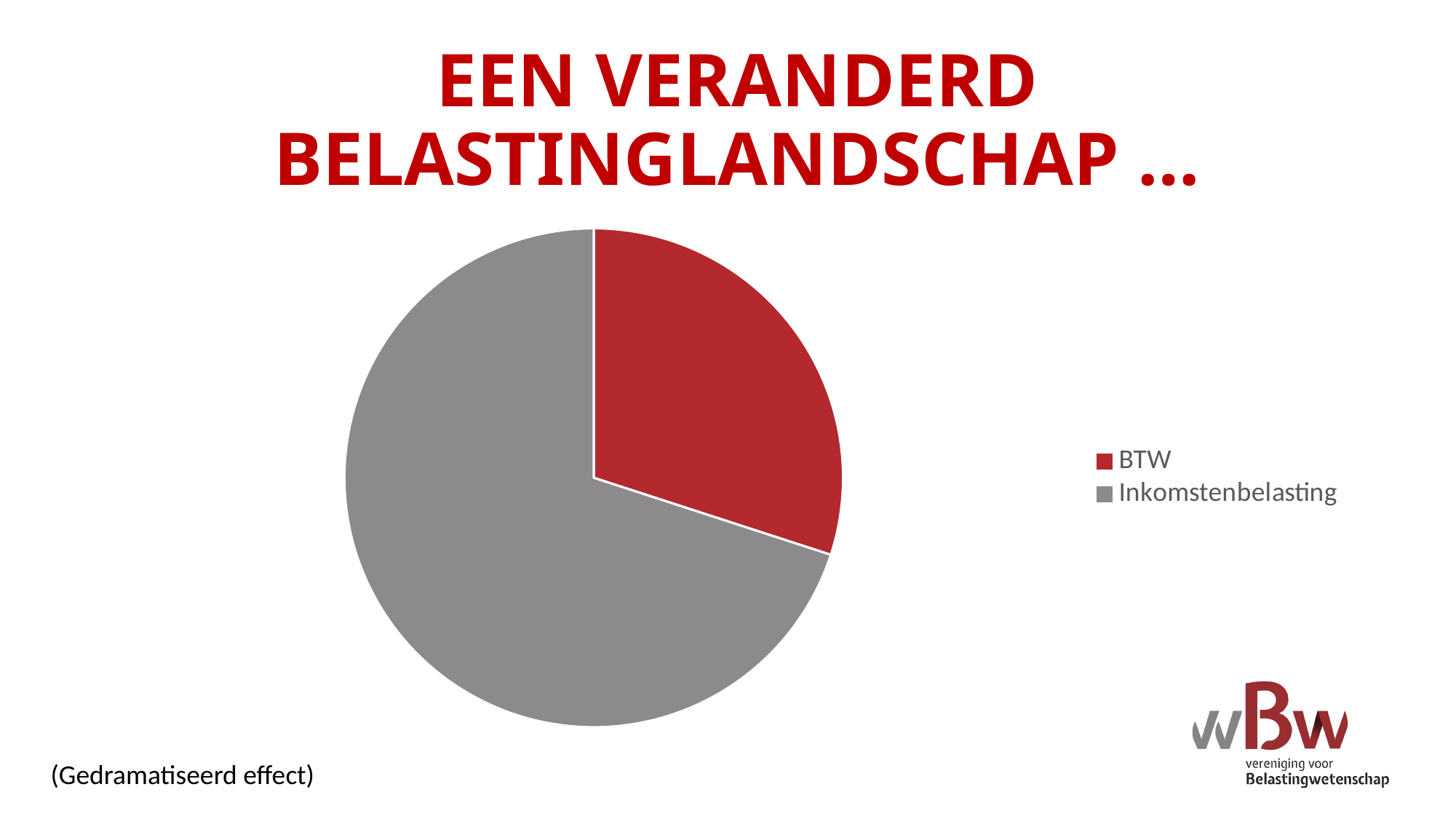
What colour is the BTW slice in the pie chart? red Which slice is larger in the pie chart, BTW or Inkomstenbelasting? Inkomstenbelasting What colour is the Inkomstenbelasting slice in the pie chart? grey How many entries does the legend of the pie chart list? 2 What kind of chart is shown on the slide? pie chart How many slices does the pie chart have? 2 Which category has the smallest slice of the pie chart? BTW Which category has the largest slice of the pie chart? Inkomstenbelasting